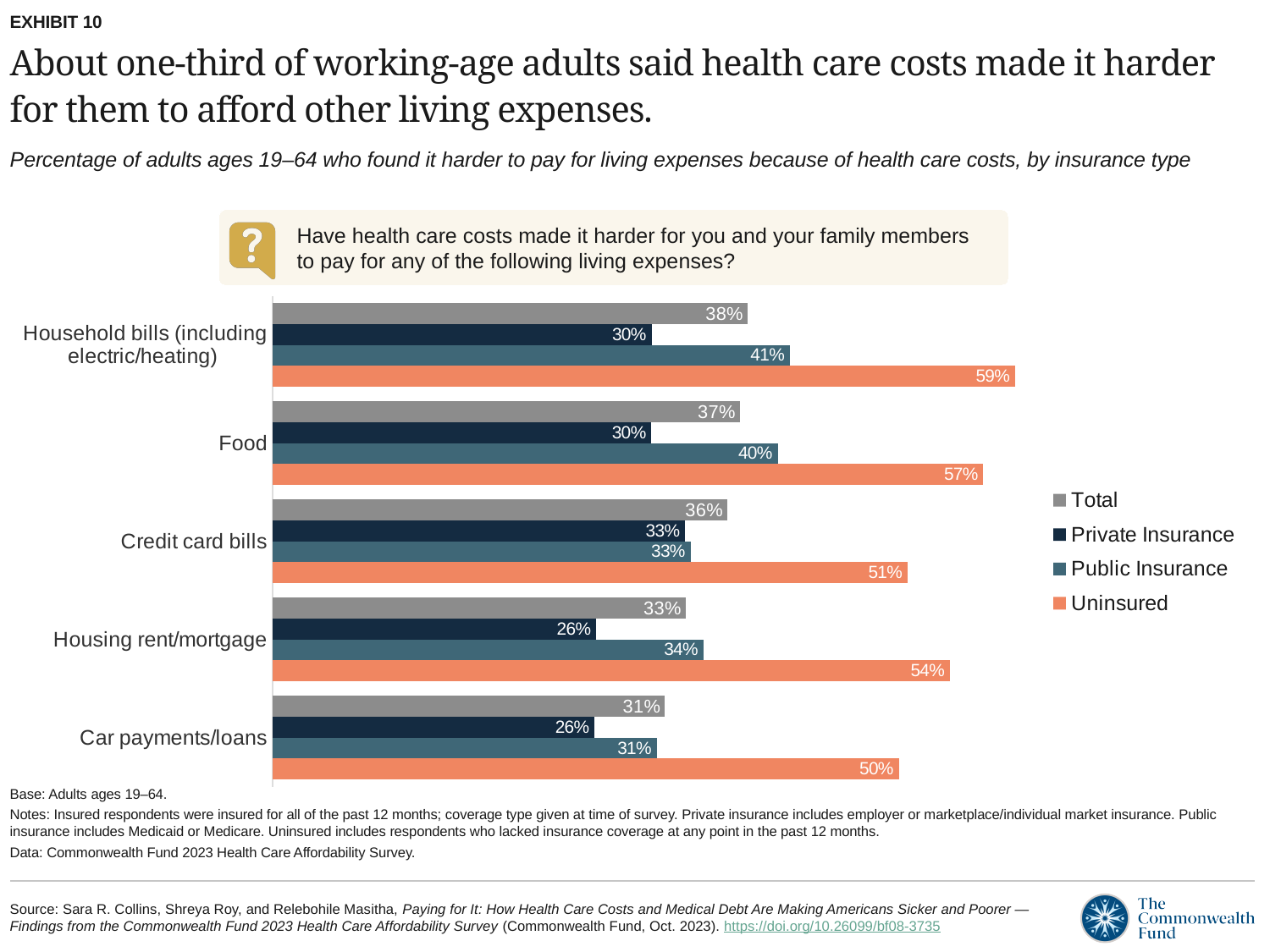
Which living expense category has the highest Uninsured value? Household bills (including electric/heating) Which series is shown in orange in the legend? Uninsured How many series does the legend list? 4 What kind of chart is shown on the slide? Bar chart How many living expense categories are shown in the chart? 5 What percentage of uninsured adults said health care costs made it harder to pay household bills (including electric/heating)? 59% What is the Total value for Food? 37% What is the value for Private Insurance in the Housing rent/mortgage category? 26% Which living expense category has the lowest Total value? Car payments/loans What is the difference between the Uninsured and Private Insurance values for Credit card bills? 18 percentage points What is the Public Insurance value for Food? 40% For Car payments/loans, which is larger: the Public Insurance value or the Private Insurance value? Public Insurance